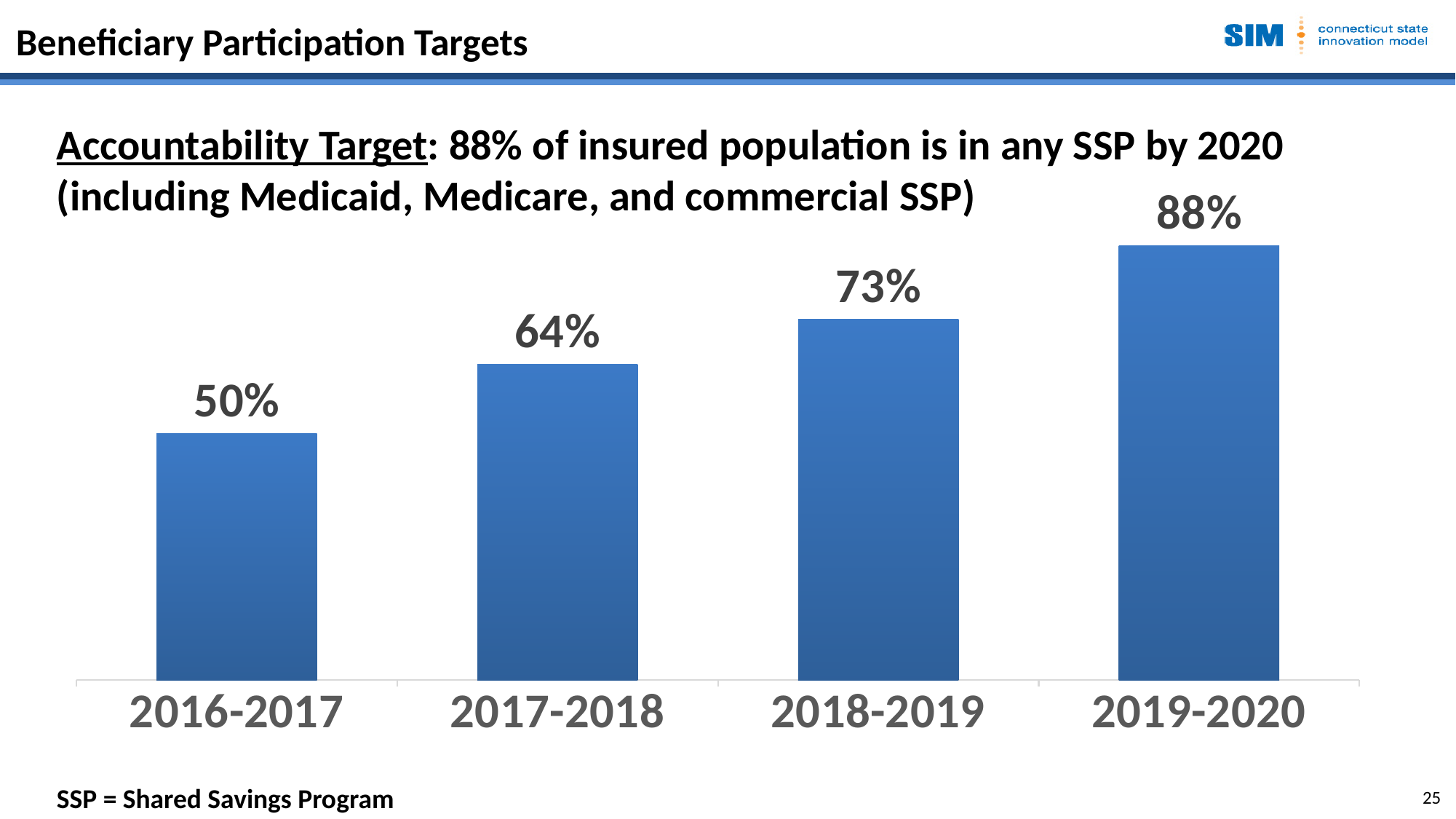
What kind of chart is shown on the slide? Bar chart Which period has the lowest value? 2016-2017 What is the value for 2016-2017? 50% What is the value for 2017-2018? 64% Do the values rise or fall from 2016-2017 to 2019-2020? Rise What is the difference between the values for 2019-2020 and 2016-2017? 38% What is the value for 2018-2019? 73% Which is larger, the value for 2017-2018 or the value for 2018-2019? 2018-2019 What is the difference between the values for 2018-2019 and 2017-2018? 9% How many periods are shown on the x axis? 4 Which period has the highest value? 2019-2020 What is the value for 2019-2020? 88%